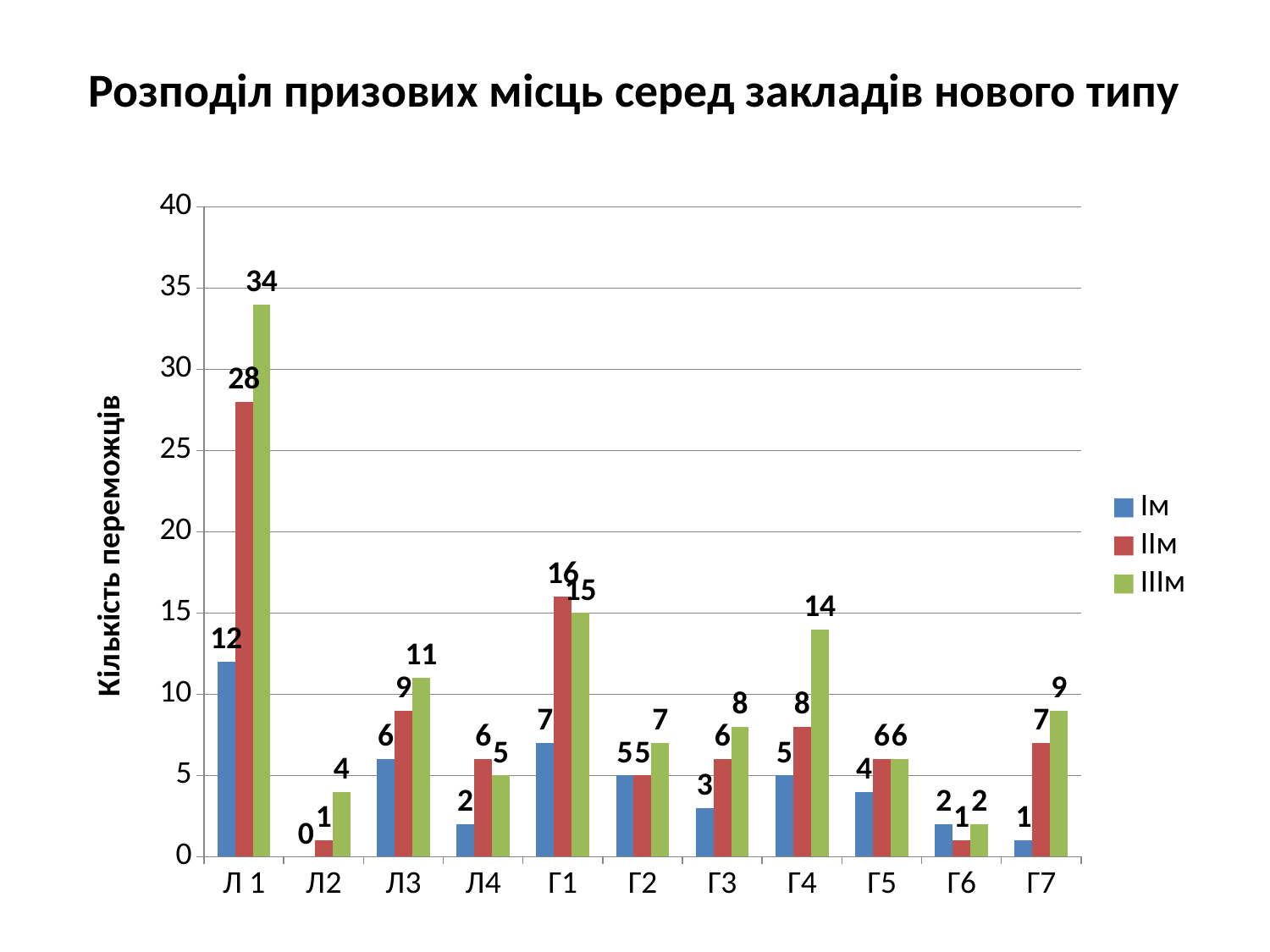
What is the value for Ім at Г5? 4 How many categories are shown on the x axis? 11 Which category has the highest value for ІІм? Л 1 What kind of chart is shown on the slide? bar chart What is the value for ІІІм at Л 1? 34 What is the value for ІІм at Г1? 16 Which category has the lowest value for Ім? Л2 How many series does the legend list? 3 Is the value for ІІм at Л 1 greater or less than 25? greater What is the label of the vertical axis? Кількість переможців Which is larger at Л4: the ІІм value or the ІІІм value? ІІм What is the difference between the ІІІм and Ім values at Г4? 9